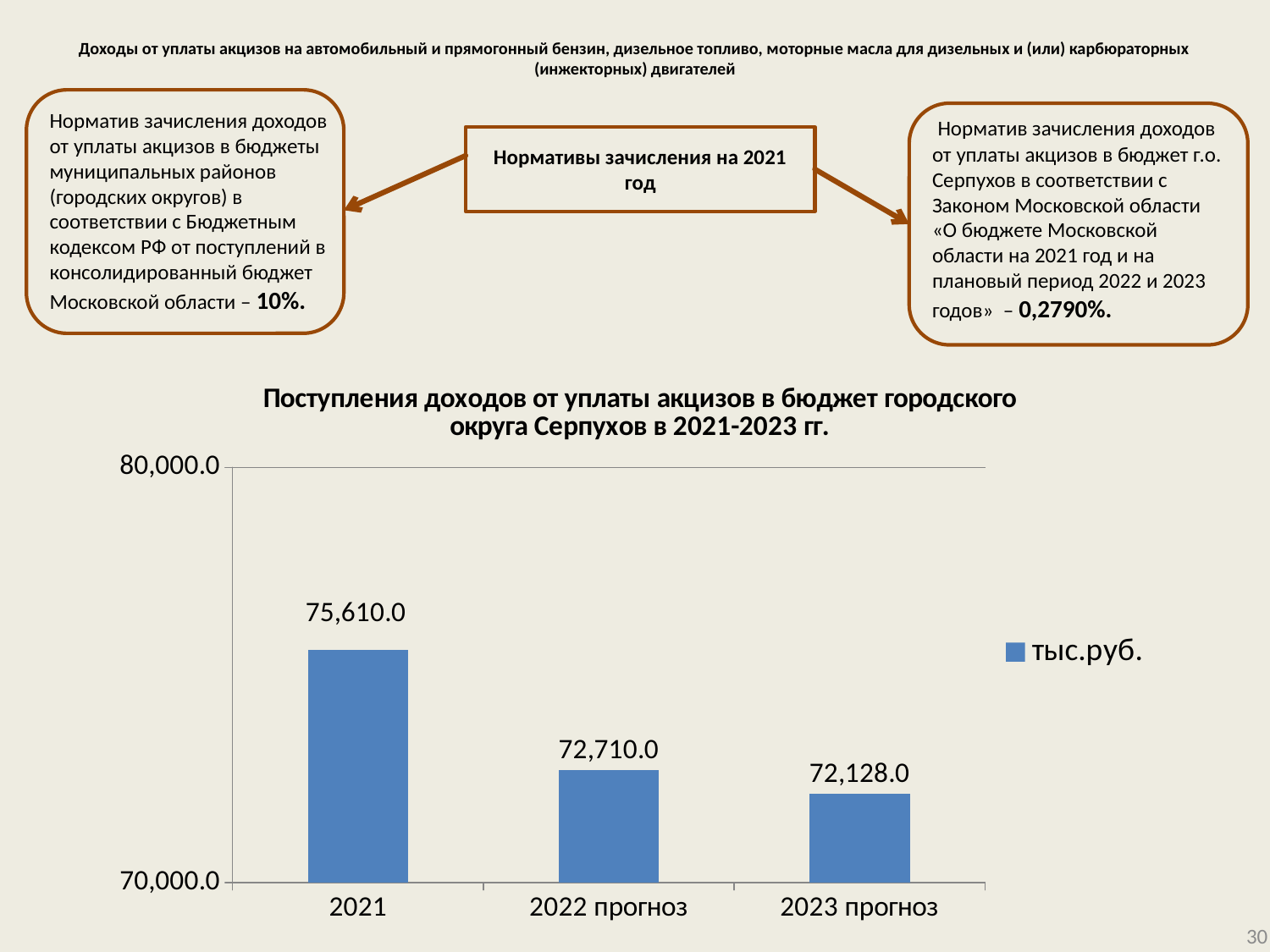
What is the value for 2023 прогноз? 72,128.0 Which category has the highest value? 2021 What is the value for 2022 прогноз? 72,710.0 How many series does the legend list? 1 Do the values rise or fall from 2021 to 2023 прогноз? fall What kind of chart is shown? bar chart How many categories are shown on the x axis? 3 What is the difference between the values for 2021 and 2022 прогноз? 2,900.0 Which category has the lowest value? 2023 прогноз What is the value for 2021? 75,610.0 Which is larger, the value for 2021 or the value for 2023 прогноз? 2021 What is the difference between the values for 2022 прогноз and 2023 прогноз? 582.0